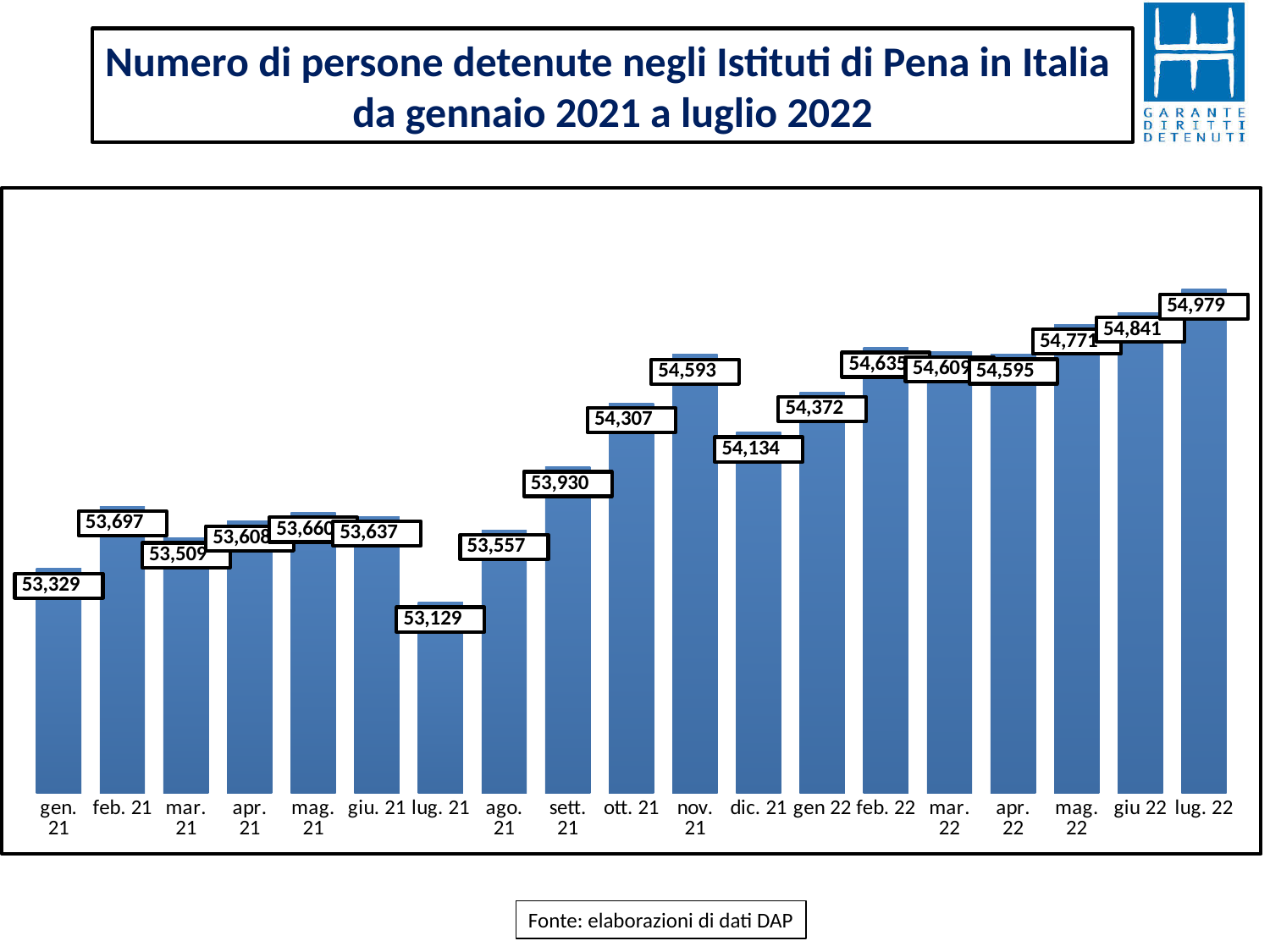
Which month has the highest value in the chart? lug. 22 What value is shown for nov. 21? 54,593 What value is shown for lug. 22? 54,979 What kind of chart is shown on the slide? Bar chart Overall, do the values rise or fall from gen. 21 to lug. 22? Rise What is the difference between the values for lug. 22 and gen. 21? 1,650 What is the number of detained persons shown for gen. 21? 53,329 Which is larger, the value for feb. 21 or the value for mar. 21? feb. 21 Which month has the lowest value in the chart? lug. 21 What value is shown for lug. 21? 53,129 What is the difference between the values for nov. 21 and dic. 21? 459 How many months are shown on the x axis? 19